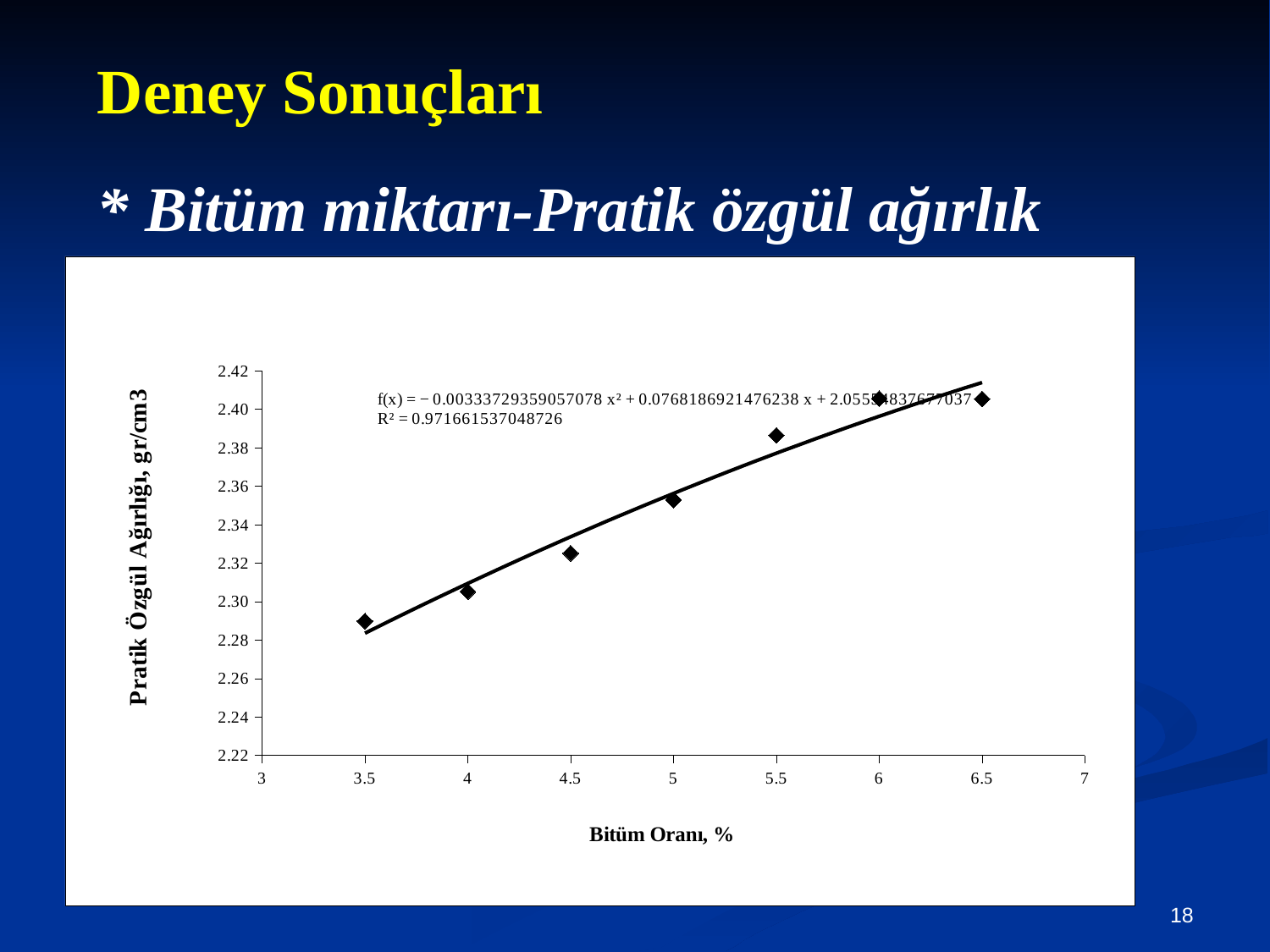
How many data points are plotted on the chart? 7 What R² value is printed on the chart? 0.971661537048726 Is the value at Bitüm Oranı 5 greater or less than 2.34? greater Is the value at Bitüm Oranı 5.5 greater or less than 2.36? greater What kind of chart is shown on the slide? scatter chart What is the title of the x axis? Bitüm Oranı, % At which Bitüm Oranı value is the Pratik Özgül Ağırlığı lowest? 3.5 Is the value at Bitüm Oranı 4 greater or less than 2.28? greater Which has the larger Pratik Özgül Ağırlığı: Bitüm Oranı 4.5 or 5.5? 5.5 Do the plotted values rise or fall as Bitüm Oranı increases from 3.5 to 6.5? rise